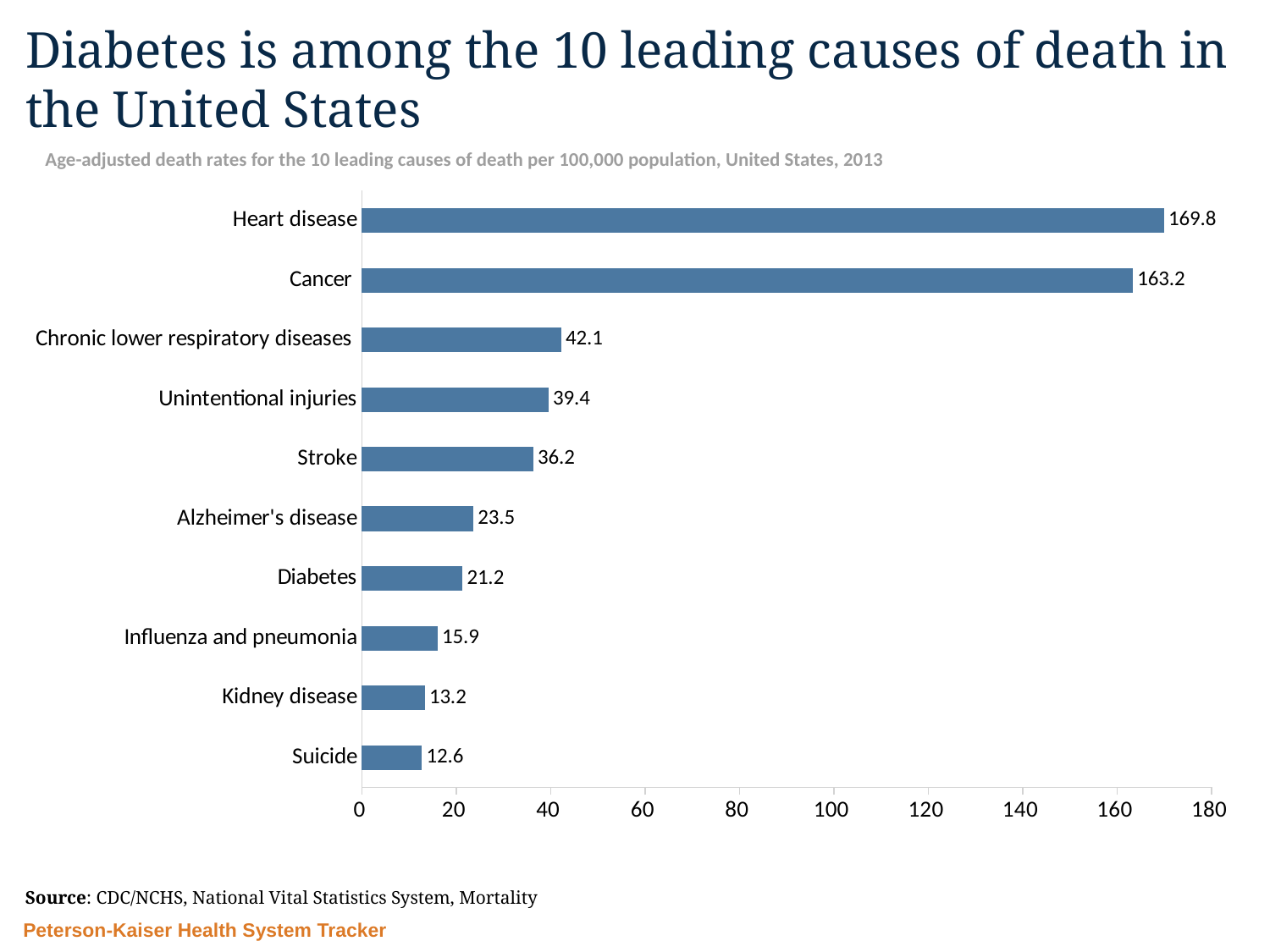
What is the age-adjusted death rate for Diabetes? 21.2 Which cause of death has the lowest age-adjusted death rate? Suicide How many causes of death are shown in the chart? 10 What is the maximum value shown on the horizontal axis? 180 What is the death rate for Influenza and pneumonia? 15.9 What is the age-adjusted death rate for Stroke? 36.2 Which has a higher death rate, Chronic lower respiratory diseases or Unintentional injuries? Chronic lower respiratory diseases What is the difference between the death rates for Alzheimer's disease and Diabetes? 2.3 Is the death rate for Cancer greater or less than 160? greater What kind of chart is shown on the slide? Bar chart What is the difference between the death rates for Heart disease and Cancer? 6.6 Which cause of death has the highest age-adjusted death rate? Heart disease